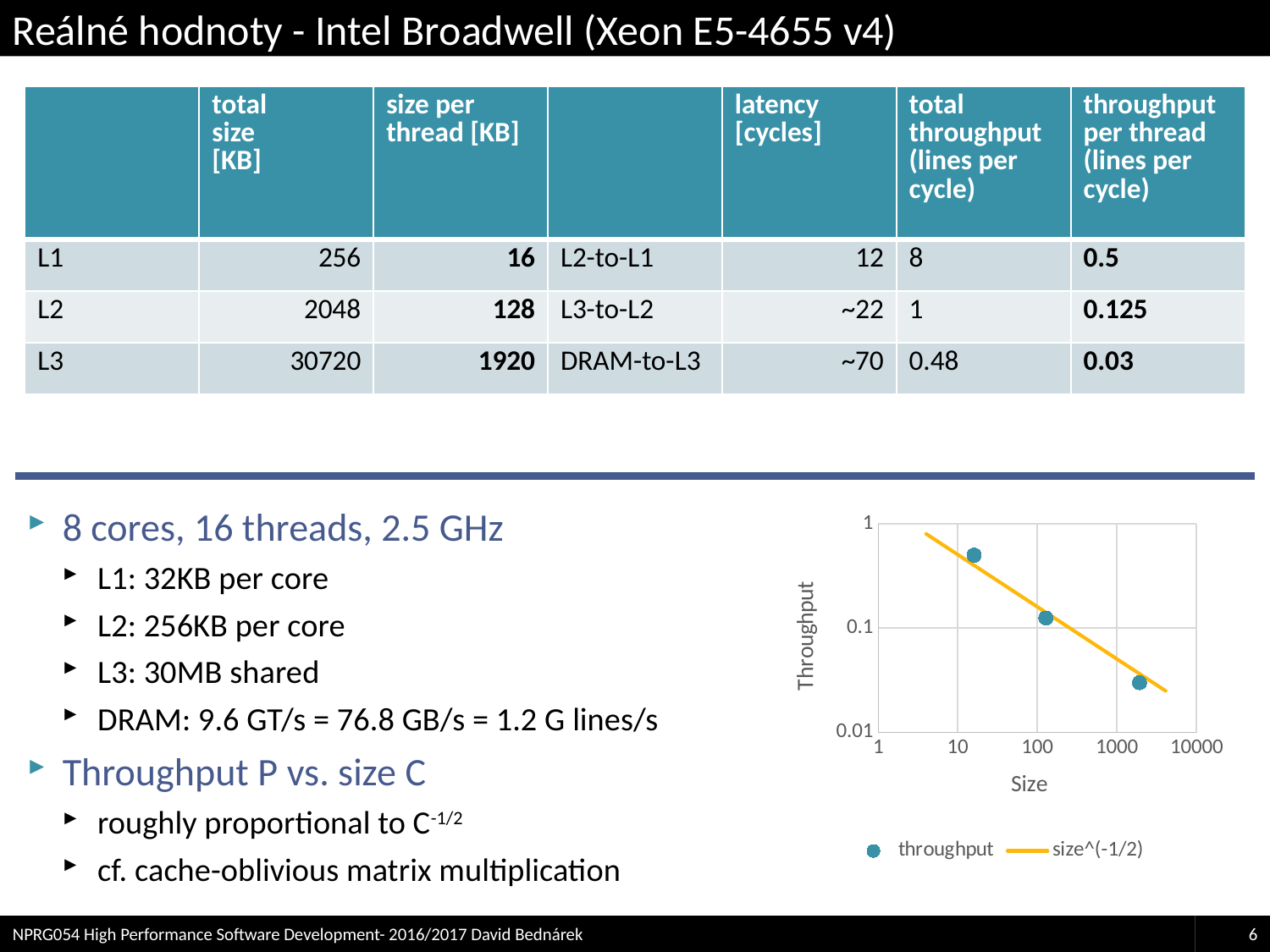
How many series does the chart legend list? 2 What kind of chart is shown on the slide? scatter chart What are the two entries in the chart legend? throughput and size^(-1/2) Do the throughput values rise or fall as size increases along the x axis? fall Is the throughput value of the leftmost plotted point greater or less than 0.1? greater Which plotted point has the highest throughput: the leftmost, middle, or rightmost? leftmost Is the throughput value of the leftmost plotted point greater or less than 1? less Is the throughput value of the rightmost plotted point greater or less than 0.1? less Which plotted point has the lowest throughput: the leftmost, middle, or rightmost? rightmost How many data points are plotted for the throughput series in the chart? 3 What is the label of the chart's x axis? Size